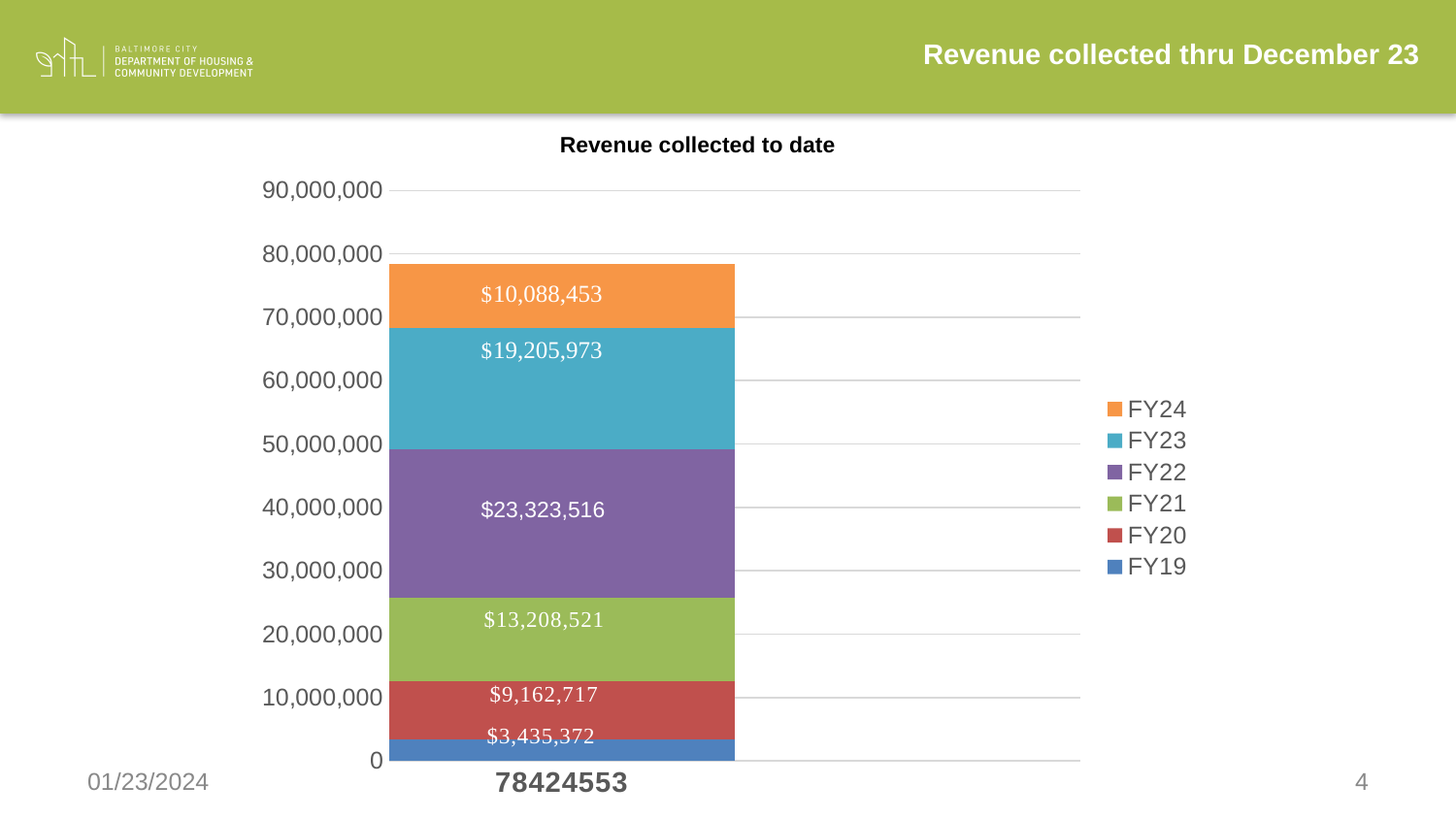
What is the difference between the FY22 and FY23 values? $4,117,543 Which is larger, the value for FY21 or the value for FY20? FY21 What is the value for FY24 in the stacked bar? $10,088,453 What is the value for FY19 in the stacked bar? $3,435,372 What is the title of the chart? Revenue collected to date Which fiscal year has the highest revenue collected to date? FY22 What is the value for FY22 in the stacked bar? $23,323,516 What is the total of the stacked bar as labelled on the x axis? 78424553 How many series does the legend list? 6 Which fiscal year has the lowest revenue collected to date? FY19 What type of chart is shown on the slide? Stacked bar chart Which colour represents FY24 in the legend? Orange